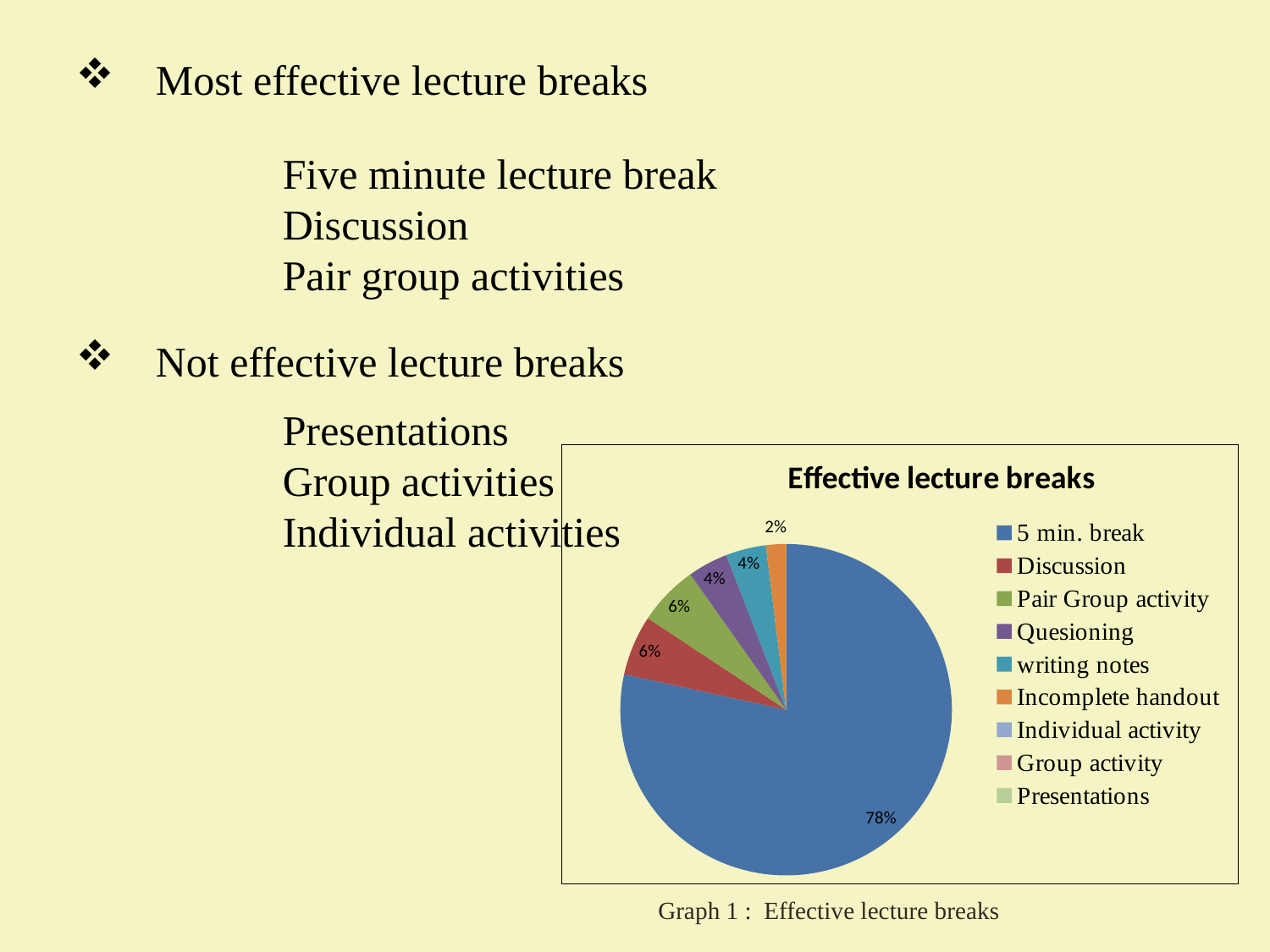
What is the value shown for Discussion? 6% What is the title of the chart? Effective lecture breaks What colour is the 5 min. break slice in the pie chart? blue What percentage of the pie does the 5 min. break slice represent? 78% What is the value shown for Pair Group activity? 6% What is the value shown for Incomplete handout? 2% What is the difference between the 5 min. break slice and the Discussion slice? 72% Which category has the largest slice of the pie? 5 min. break What is the value shown for Quesioning? 4% What kind of chart is shown on the slide? pie chart Which is larger, the slice for writing notes or the slice for Incomplete handout? writing notes How many entries does the chart's legend list? 9